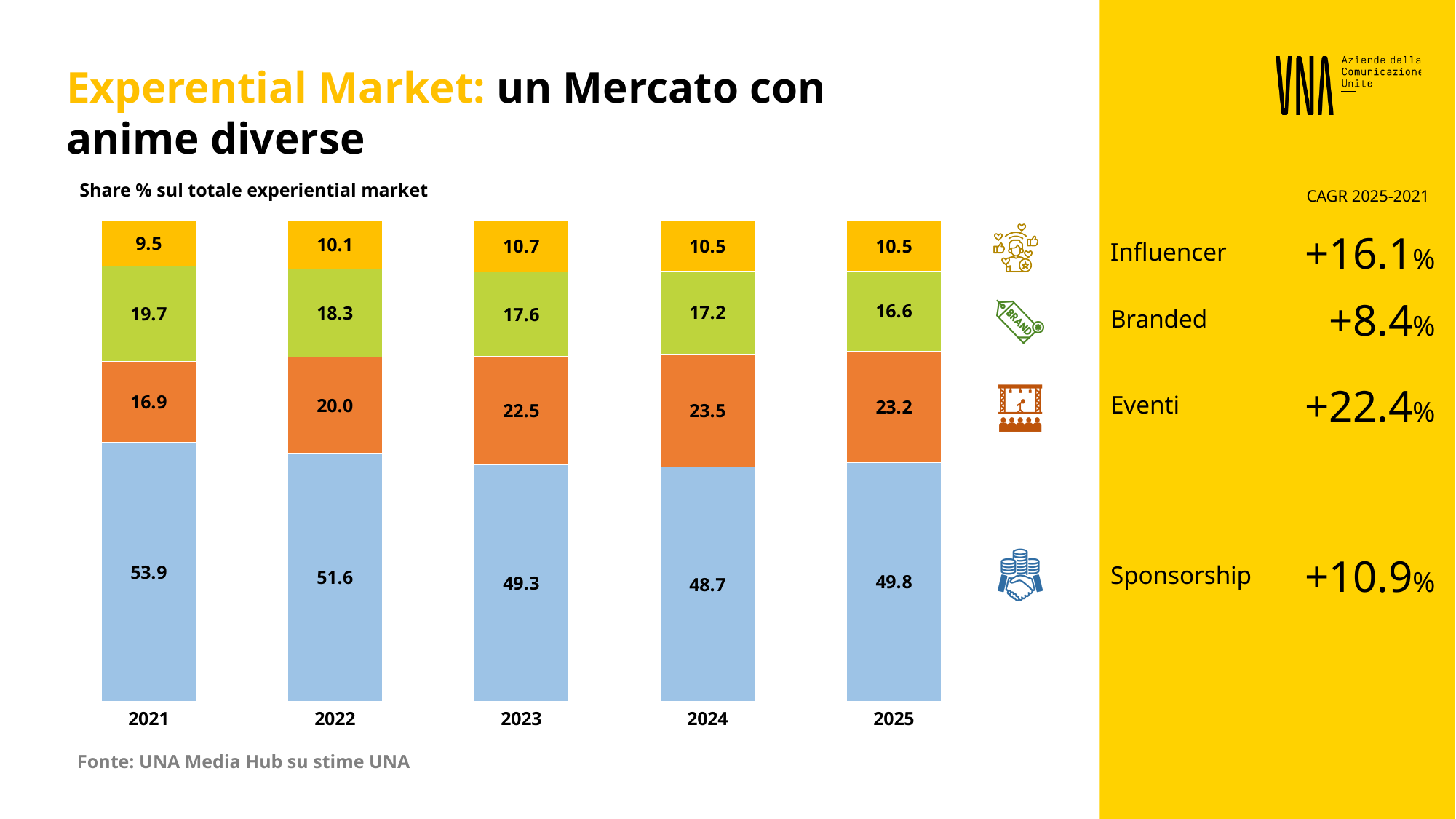
In which year is the Sponsorship (blue) share the highest? 2021 What is the share for the bottom (blue) segment, Sponsorship, in 2021? 53.9 By how much does the Sponsorship (blue) share fall from 2021 to 2025? 4.1 In which year is the Eventi (orange) share the lowest? 2021 What is the share for the orange segment (Eventi) in 2024? 23.5 How many segments (series) make up each stacked bar? 4 What kind of chart is shown on the slide? Stacked bar chart Does the Branded (green) share rise or fall from 2021 to 2025? Fall What is the share for the green segment (Branded) in 2025? 16.6 What is the share for the top (yellow) segment, Influencer, in 2023? 10.7 How many years are shown on the x axis of the chart? 5 Which is larger in 2022: the Eventi (orange) share or the Branded (green) share? Eventi (20.0)